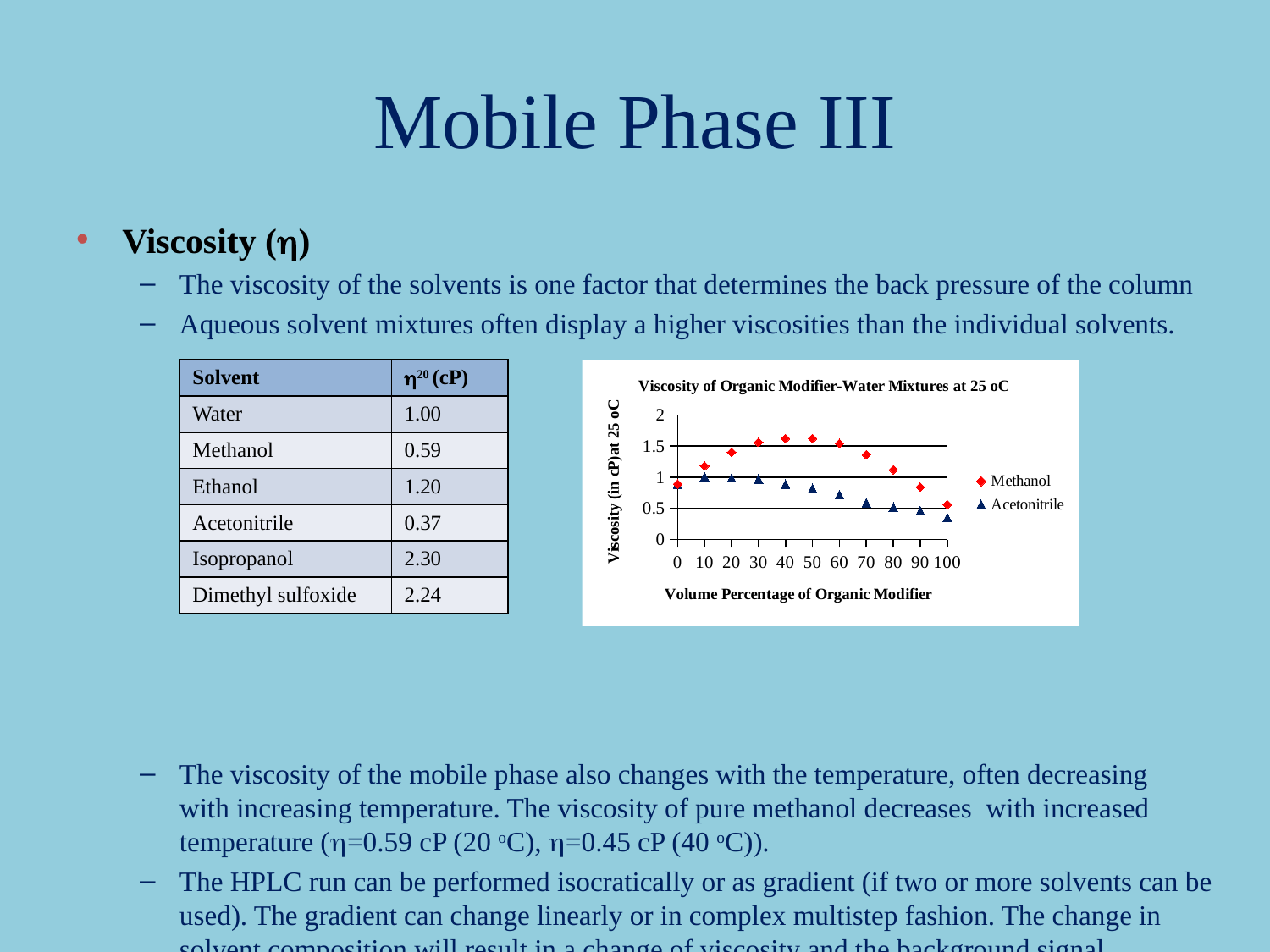
What is the title of the chart? Viscosity of Organic Modifier-Water Mixtures at 25 oC How many series does the chart legend list? 2 How many data points are plotted for the Methanol series? 11 Is the viscosity value for Acetonitrile at 60% organic modifier greater or less than 0.5? greater At which volume percentage of organic modifier is the Acetonitrile viscosity lowest? 100 Is the viscosity value for Methanol at 10% organic modifier greater or less than 1? greater Which two series are listed in the chart legend? Methanol and Acetonitrile Is the viscosity value for Acetonitrile at 100% organic modifier greater or less than 0.5? less Does the Acetonitrile viscosity generally rise or fall as the volume percentage of organic modifier increases from 10 to 100? fall At 50% organic modifier, which series has the higher viscosity, Methanol or Acetonitrile? Methanol What kind of chart is shown on the slide? Scatter chart